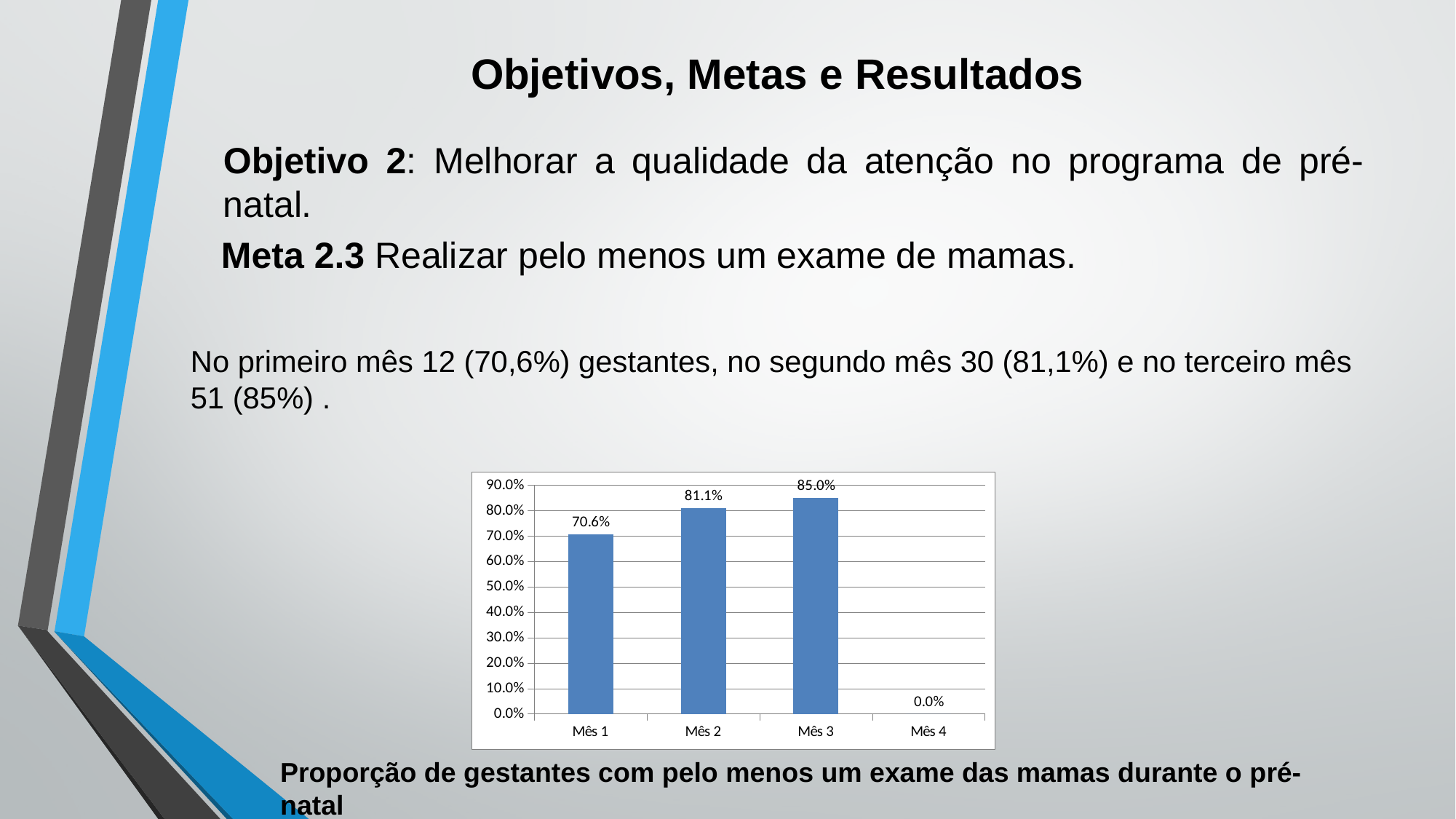
Is the value for Mês 2 greater or less than 80.0%? greater Do the values rise or fall from Mês 1 to Mês 3? rise What is the value for Mês 4? 0.0% Which month has the highest value? Mês 3 What kind of chart is shown on the slide? bar chart Which month has the lowest value? Mês 4 What is the value for Mês 3? 85.0% How many categories are shown on the x axis? 4 Which is larger, the value for Mês 2 or the value for Mês 1? Mês 2 What is the value for Mês 2? 81.1% What is the value for Mês 1? 70.6% What is the difference between the values for Mês 3 and Mês 1? 14.4%